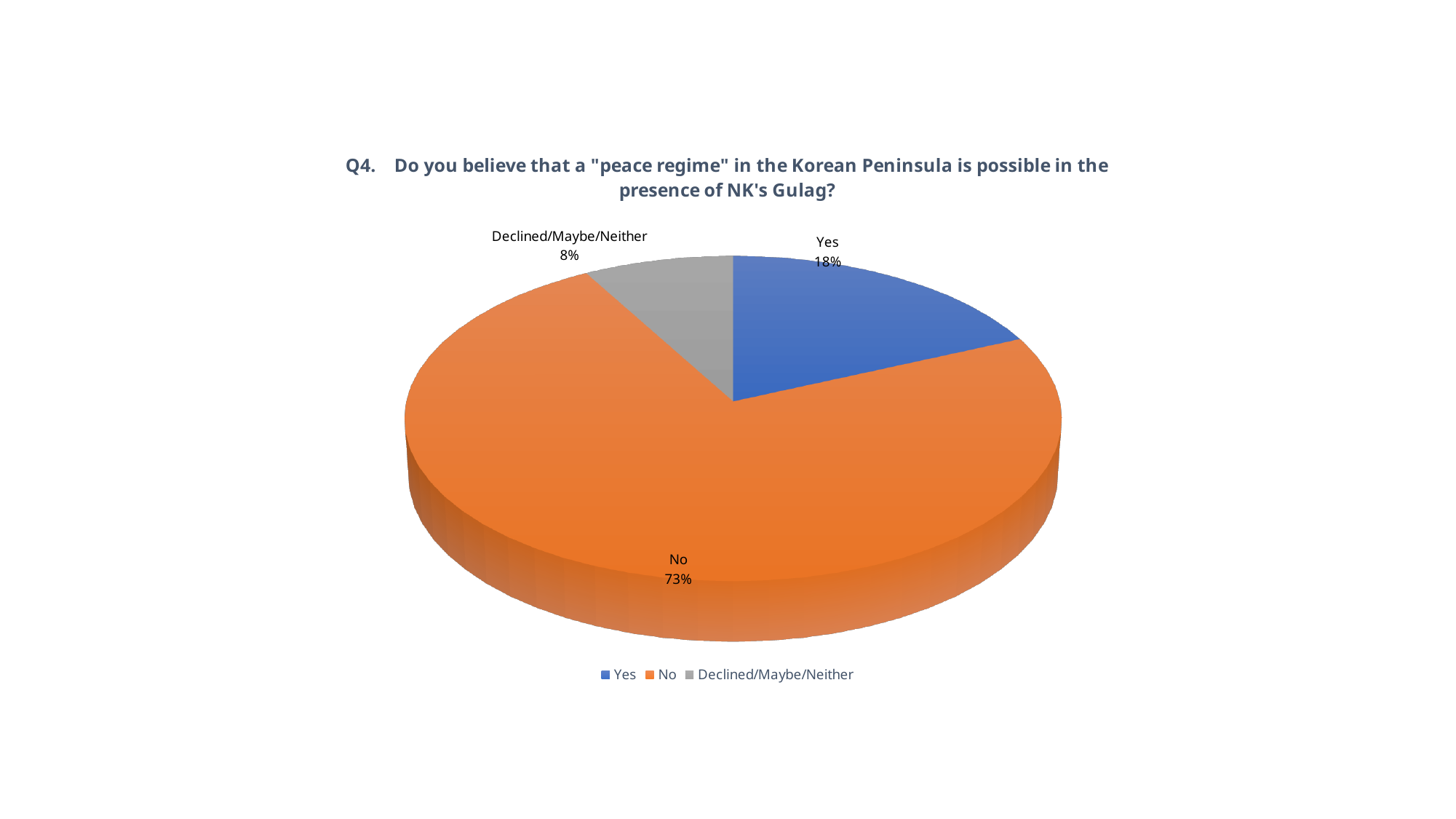
What colour is the "No" slice? Orange Which is larger, the "Yes" slice or the "Declined/Maybe/Neither" slice? Yes Which response has the smallest slice of the pie? Declined/Maybe/Neither How many entries does the legend list? 3 What is the difference in percentage points between the "No" and "Yes" slices? 55 What percentage of respondents answered "No"? 73% Which response has the largest slice of the pie? No How many slices does the pie chart have? 3 What is the question number shown at the start of the chart title? Q4 What kind of chart is shown on the slide? Pie chart What percentage of respondents answered "Yes"? 18% What share of the pie is labelled "Declined/Maybe/Neither"? 8%